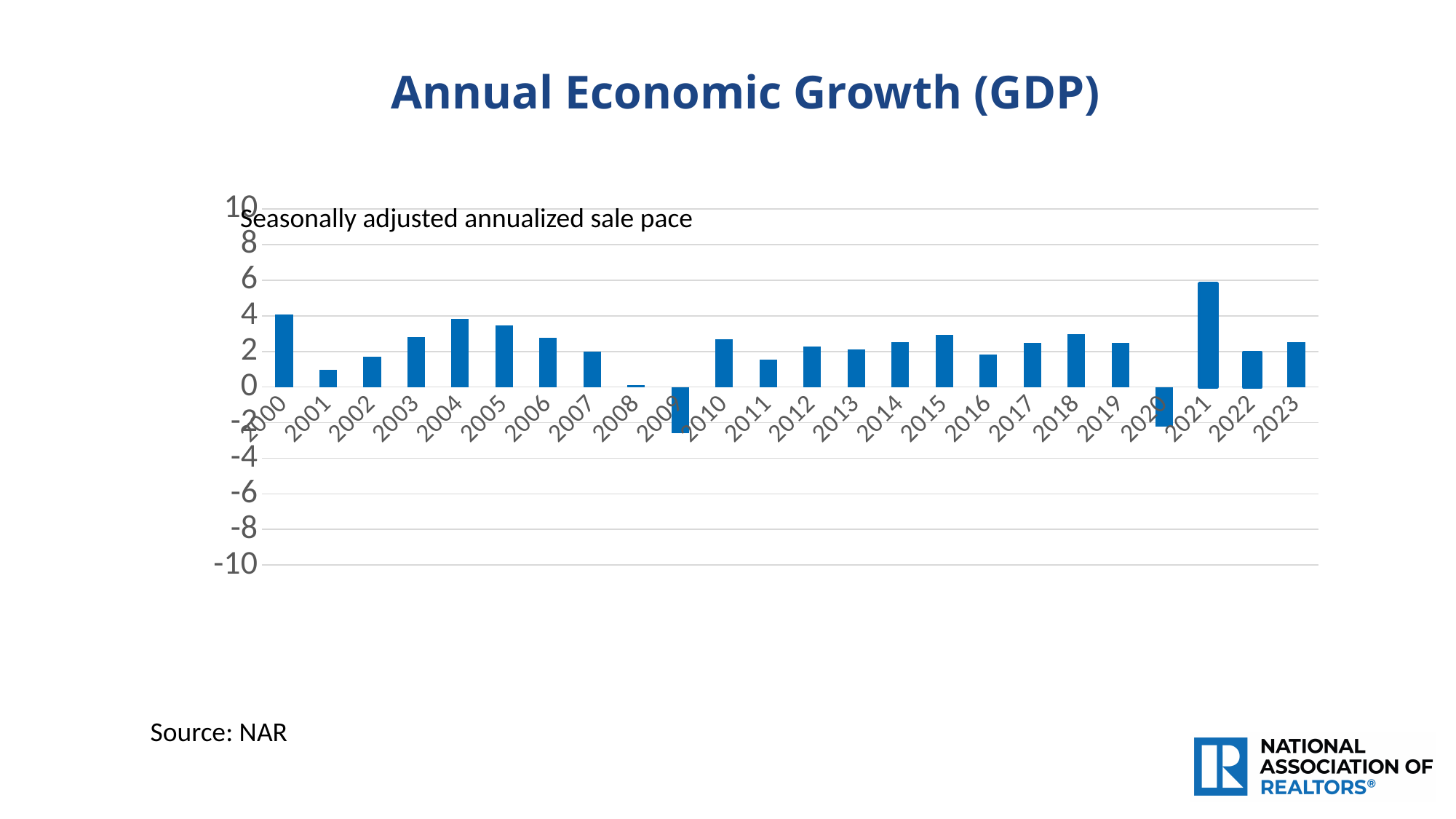
What type of chart is shown on the slide? Bar chart Is the value for 2000 greater or less than 2? greater How many years are plotted on the x axis of the chart? 24 Which is larger, the value for 2020 or the value for 2022? 2022 Is the value for 2009 greater or less than 0? less What is the title of the chart? Annual Economic Growth (GDP) What source is cited for the chart? NAR Is the value for 2001 greater or less than 2? less Which is larger, the value for 2004 or the value for 2008? 2004 Which year has the highest value in the chart? 2021 Which year has the lowest value in the chart? 2009